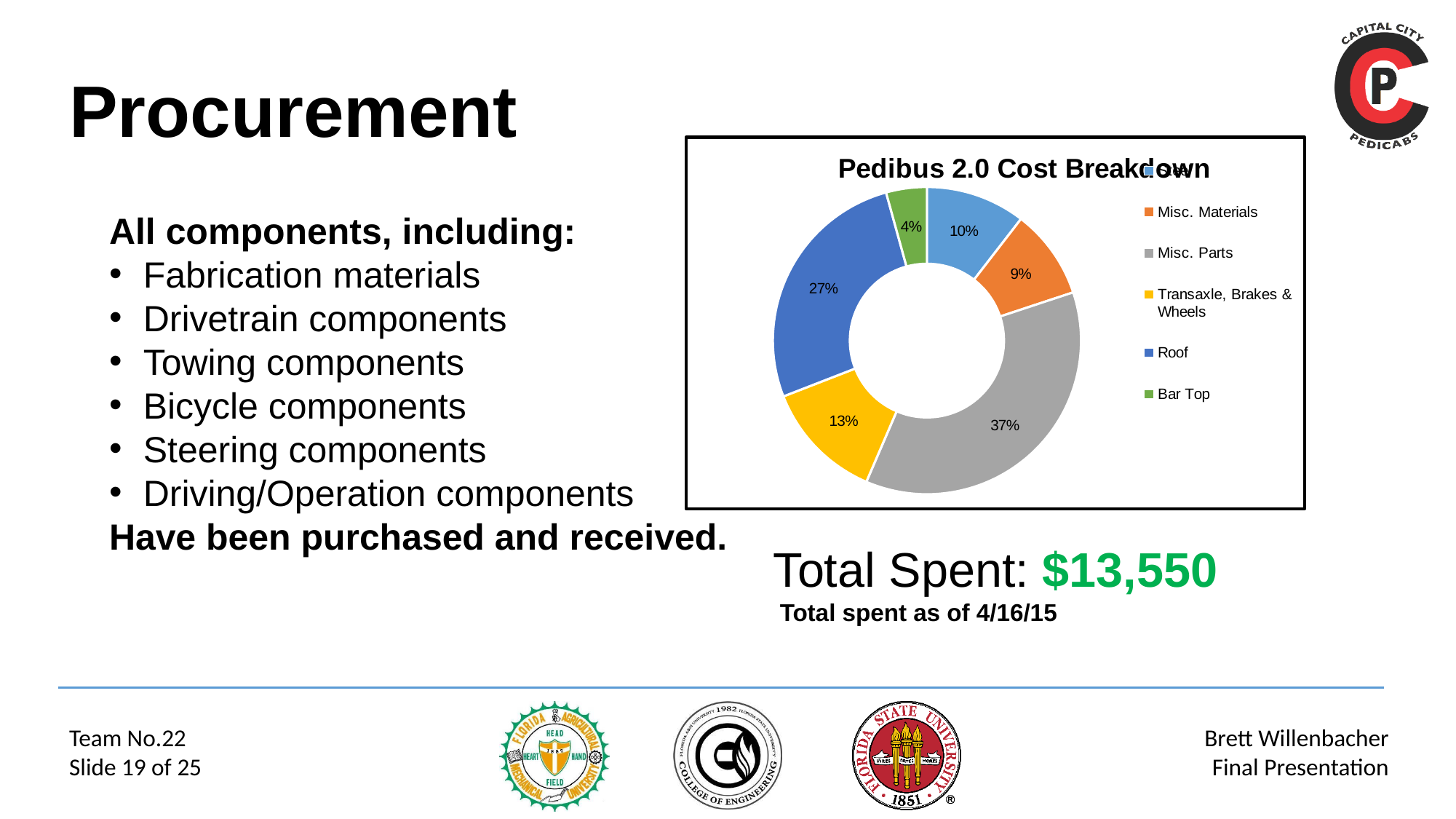
What percentage of the cost breakdown is Misc. Materials? 9% What share of the Pedibus 2.0 Cost Breakdown chart is Misc. Parts? 37% What percentage does the Roof slice represent in the Pedibus 2.0 Cost Breakdown chart? 27% Which category has the largest share in the Pedibus 2.0 Cost Breakdown chart? Misc. Parts Which category has the smallest share in the Pedibus 2.0 Cost Breakdown chart? Bar Top Which has a larger share of the cost breakdown, Roof or Transaxle, Brakes & Wheels? Roof What kind of chart is used to show the Pedibus 2.0 Cost Breakdown? Doughnut (pie) chart What is the percentage shown for Transaxle, Brakes & Wheels in the cost breakdown chart? 13% By how many percentage points does the Misc. Parts share exceed the Roof share? 10 percentage points What share of the cost breakdown does Bar Top account for? 4% How many entries does the legend of the Pedibus 2.0 Cost Breakdown chart list? 6 What is the title of the chart on the slide? Pedibus 2.0 Cost Breakdown